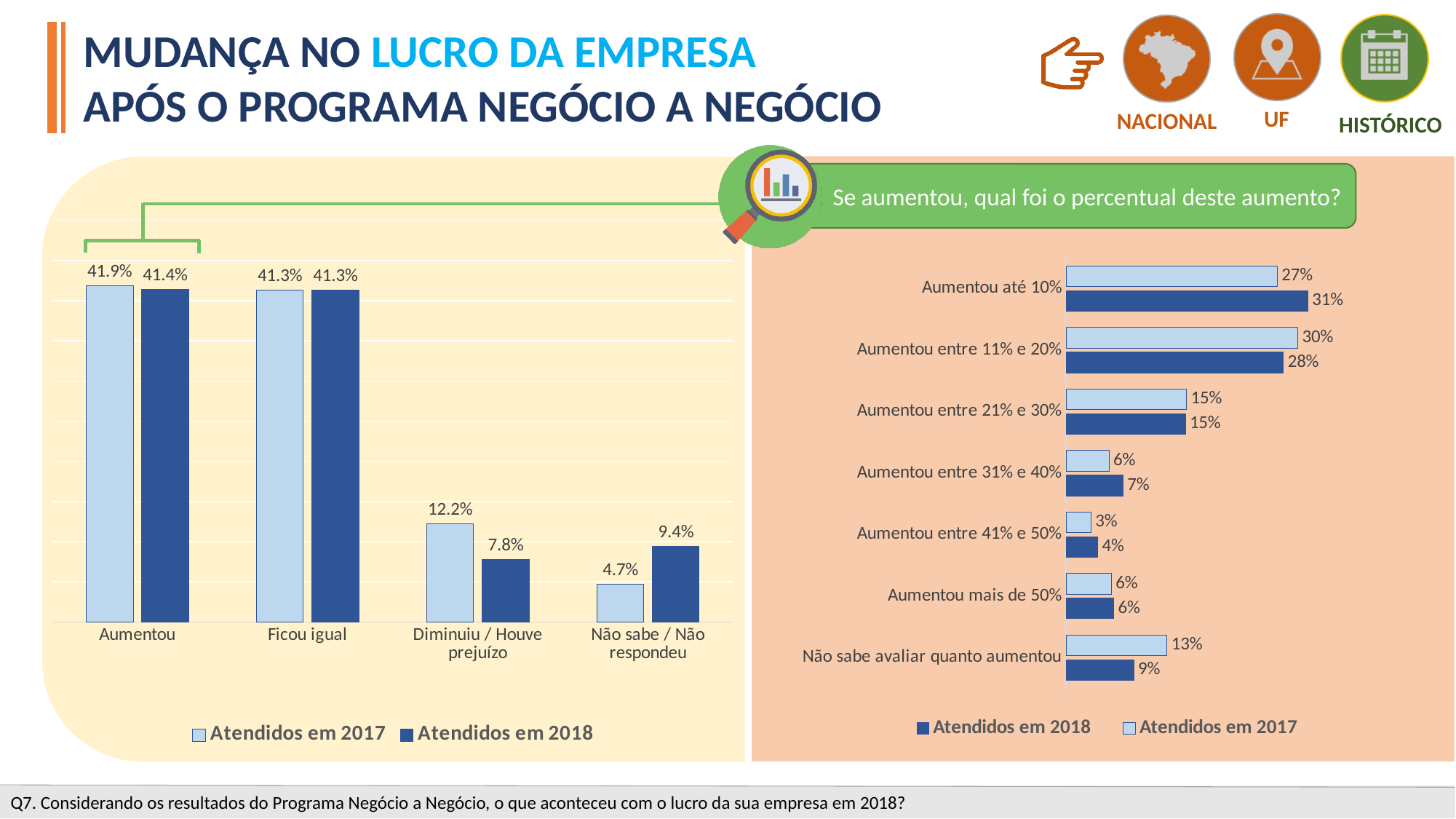
In the left chart, how many categories are shown on the x axis? 4 In the chart 'Se aumentou, qual foi o percentual deste aumento?', what is the value for 'Aumentou até 10%' for Atendidos em 2018? 31% In the left chart, which is larger for 'Não sabe / Não respondeu': Atendidos em 2017 or Atendidos em 2018? Atendidos em 2018 What type of chart is 'Se aumentou, qual foi o percentual deste aumento?'? Bar chart In the left chart, which category has the highest value for Atendidos em 2017? Aumentou How many series does the legend of the left chart list? 2 In the left chart, what is the value for 'Não sabe / Não respondeu' for Atendidos em 2018? 9.4% In the left chart, what is the value for 'Diminuiu / Houve prejuízo' for Atendidos em 2017? 12.2% In the chart 'Se aumentou, qual foi o percentual deste aumento?', what is the value for 'Não sabe avaliar quanto aumentou' for Atendidos em 2017? 13% In the chart 'Se aumentou, qual foi o percentual deste aumento?', which category has the lowest value for Atendidos em 2017? Aumentou entre 41% e 50% In the left chart, what is the difference between the 2017 and 2018 values for 'Diminuiu / Houve prejuízo'? 4.4% In the chart 'Se aumentou, qual foi o percentual deste aumento?', what is the difference between the 2017 and 2018 values for 'Aumentou até 10%'? 4%